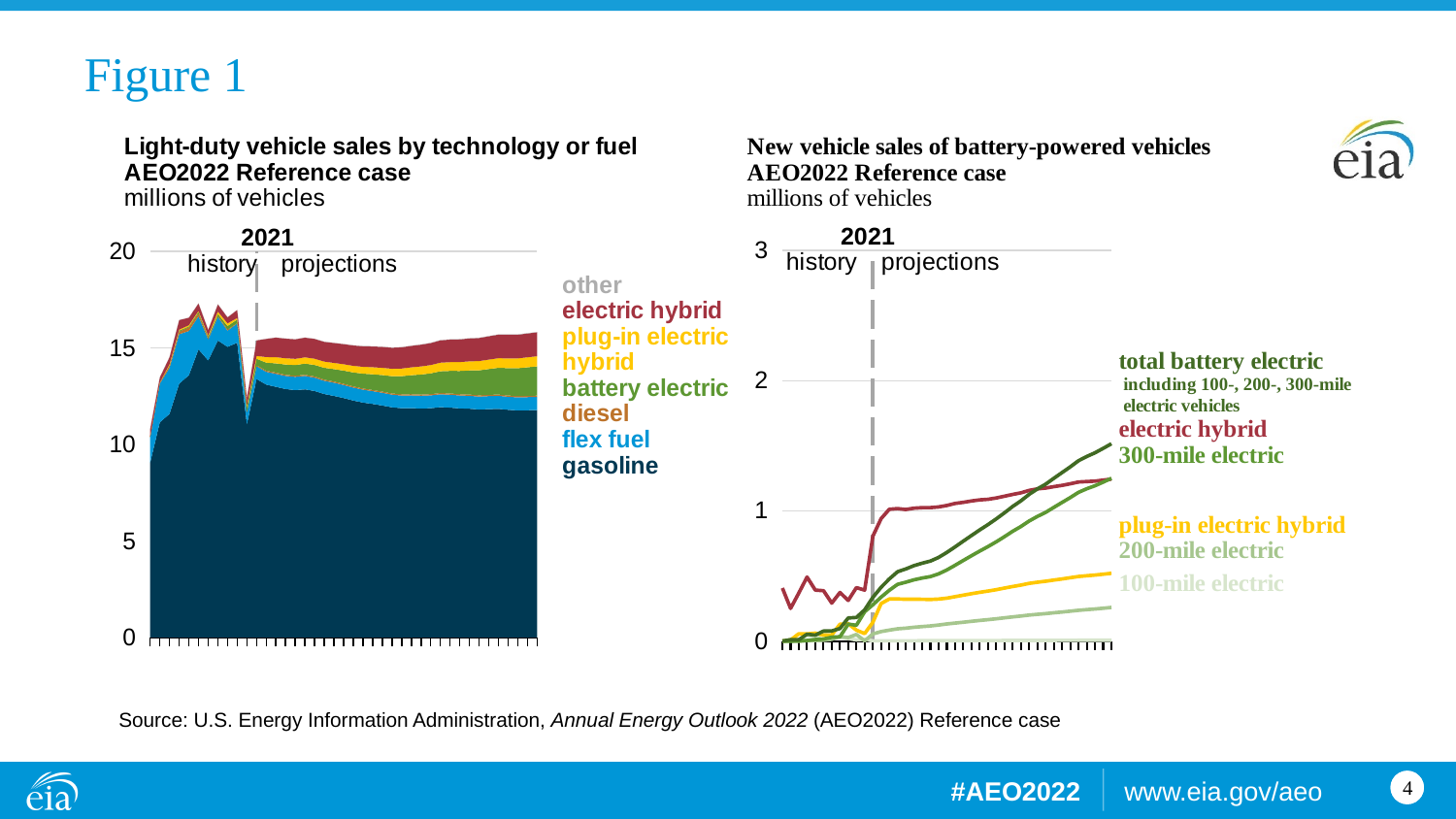
In the right chart, 'New vehicle sales of battery-powered vehicles', how many series are labelled? 6 What year does the dashed vertical line separating history from projections mark in both charts? 2021 What kind of chart is the left chart, 'Light-duty vehicle sales by technology or fuel'? stacked area chart In the right chart, 'New vehicle sales of battery-powered vehicles', which is larger at the end of the projection period: 300-mile electric or 100-mile electric? 300-mile electric What kind of chart is the right chart, 'New vehicle sales of battery-powered vehicles'? line chart In the left chart, 'Light-duty vehicle sales by technology or fuel', is the value for gasoline at the end of the projection period greater or less than 10? greater What unit of measurement is shown for both charts on the slide? millions of vehicles In the right chart, 'New vehicle sales of battery-powered vehicles', is the value for plug-in electric hybrid at the end of the projection period greater or less than 1? less In the right chart, 'New vehicle sales of battery-powered vehicles', which is larger at the end of the projection period: total battery electric or plug-in electric hybrid? total battery electric In the right chart, 'New vehicle sales of battery-powered vehicles', does the total battery electric line rise or fall over the projection period? rise In the left chart, 'Light-duty vehicle sales by technology or fuel', how many series are listed in the legend? 7 In the right chart, 'New vehicle sales of battery-powered vehicles', is the value for total battery electric at the end of the projection period greater or less than 1? greater